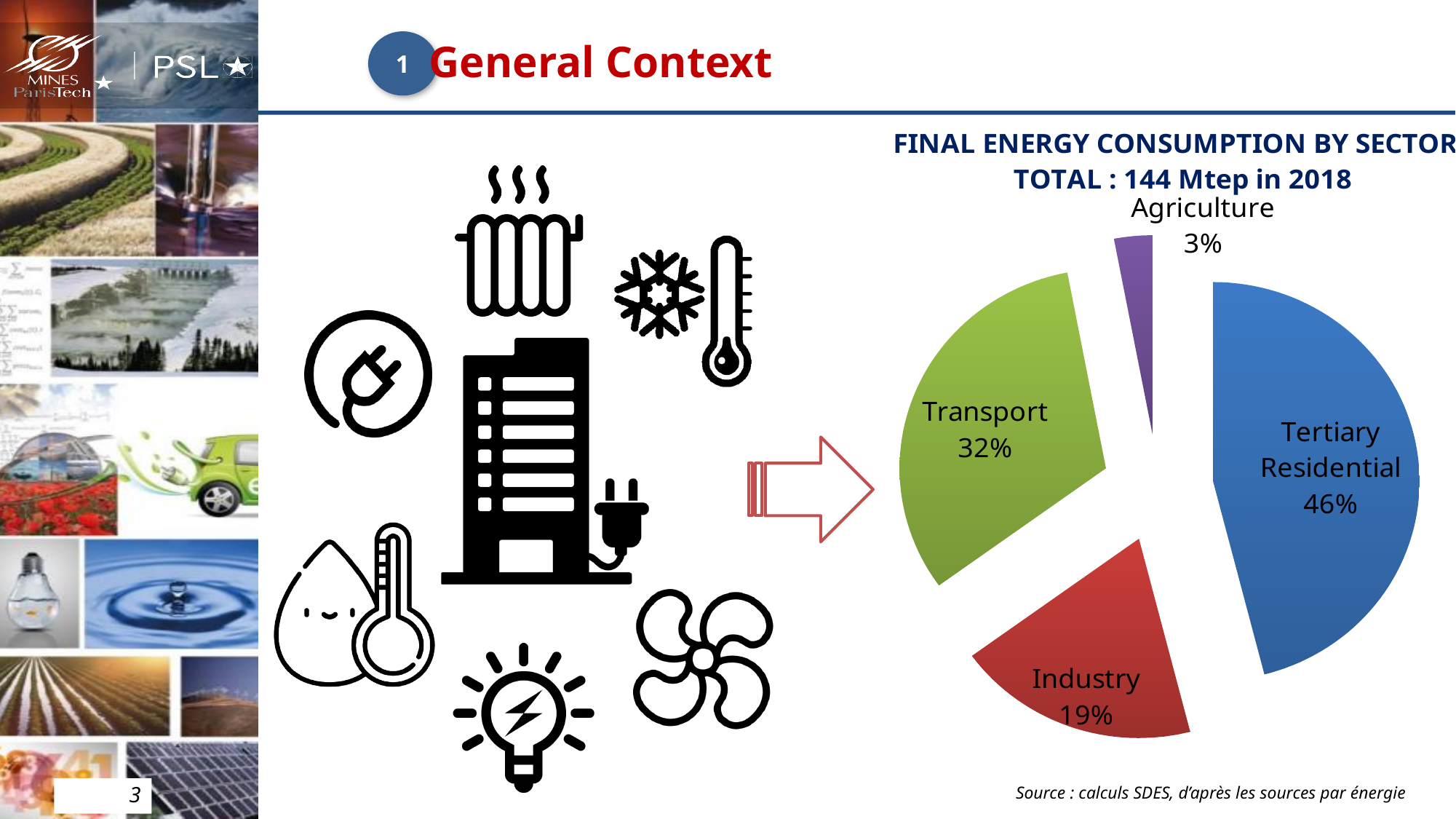
What share of final energy consumption does the Industry slice represent? 19% Which sector has the smallest share of final energy consumption? Agriculture Which sector has a larger share, Industry or Transport? Transport What is the difference in percentage points between the Transport share and the Industry share? 13 What share of final energy consumption does the Transport slice represent? 32% How many sectors are shown in the pie chart? 4 What share of final energy consumption does the Tertiary Residential slice represent? 46% What kind of chart is used to show final energy consumption by sector? Pie chart What share of final energy consumption does the Agriculture slice represent? 3% What total final energy consumption in 2018 is stated in the chart title? 144 Mtep Which sector has the largest share of final energy consumption? Tertiary Residential What is the difference in percentage points between the Tertiary Residential share and the Transport share? 14